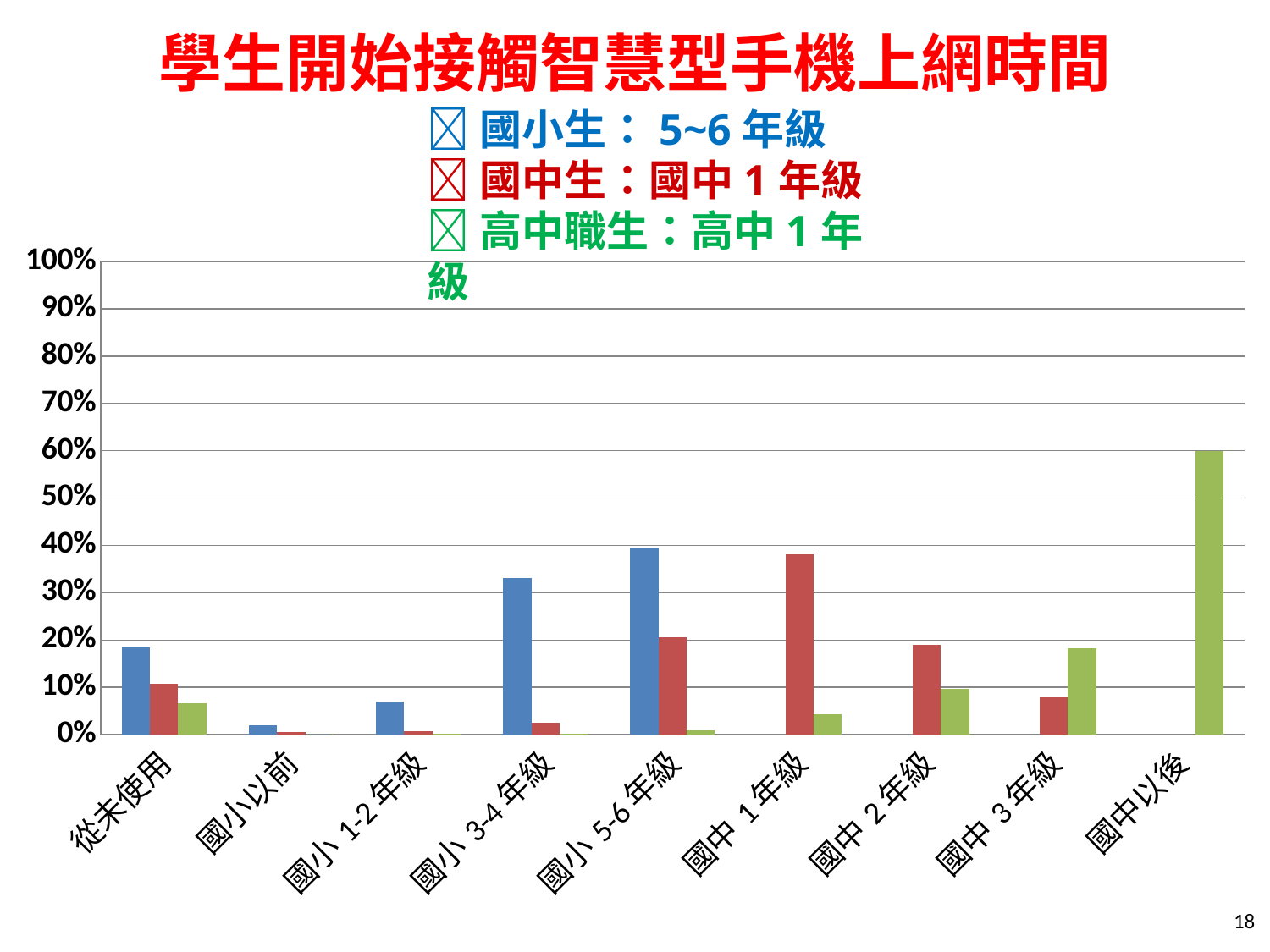
At 國中 3 年級, which is larger: the 國中生 (red) value or the 高中職生 (green) value? 高中職生 (green) Is the 國小生 (blue) value for 從未使用 greater or less than 20%? less How many student groups (series) does the legend list? 3 For the 國中生 (red) series, which category has the highest value? 國中 1 年級 Is the 高中職生 (green) value for 國中以後 greater or less than 50%? greater What is the title of the chart? 學生開始接觸智慧型手機上網時間 At 國小 5-6 年級, which is larger: the 國小生 (blue) value or the 國中生 (red) value? 國小生 (blue) What kind of chart is shown on the slide? bar chart How many categories are shown along the x axis of the chart? 9 Is the 國中生 (red) value for 國中 1 年級 greater or less than 30%? greater For the 國小生 (blue) series, which category has the highest value? 國小 5-6 年級 Which category has the tallest bar in the chart? 國中以後